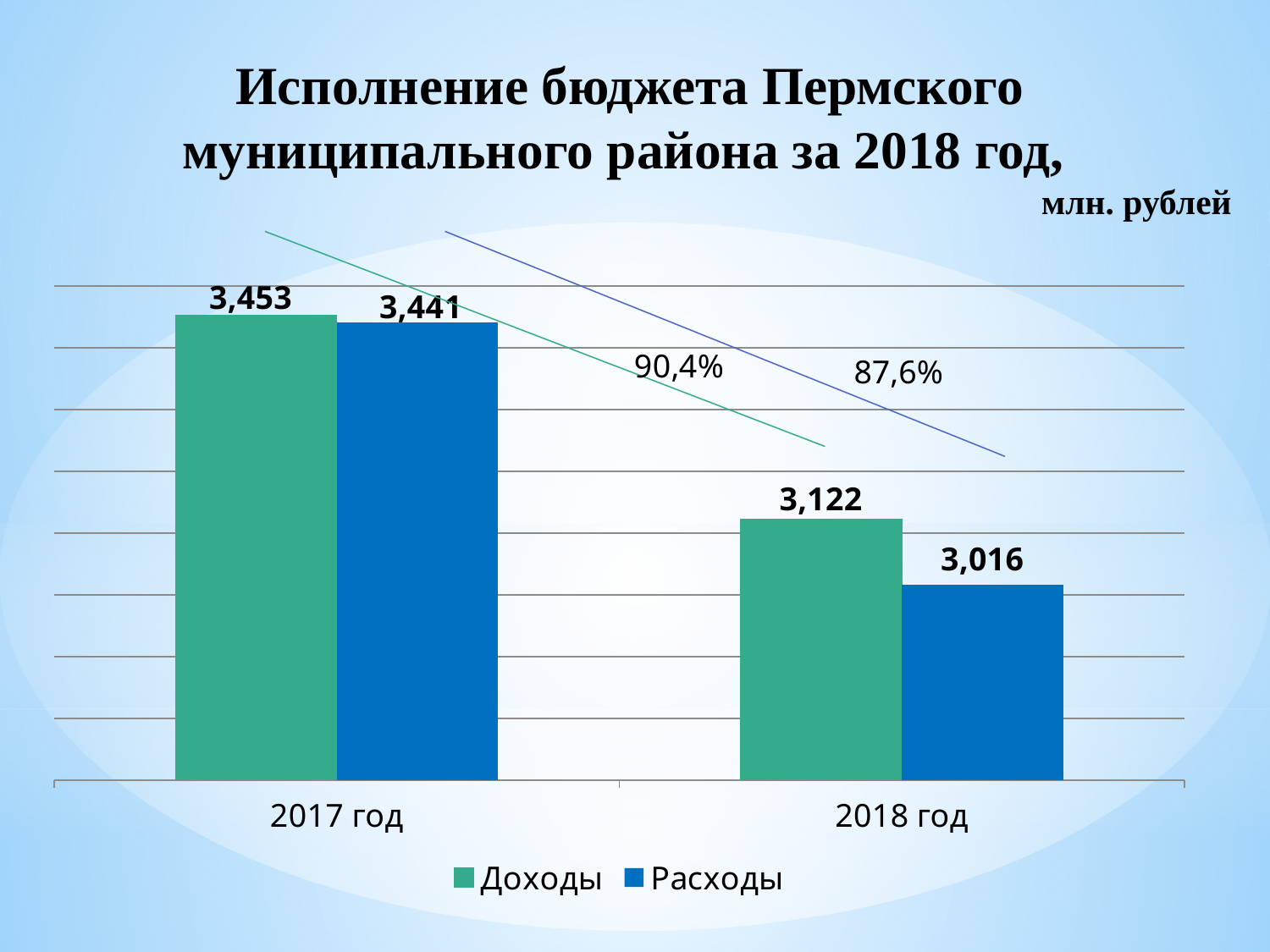
Which is larger for 2018 год, Доходы or Расходы? Доходы How many series does the legend list? 2 Which bar has the highest value on the chart? Доходы, 2017 год By how much did Доходы decrease from 2017 год to 2018 год? 331 What is the difference between Доходы and Расходы for 2018 год? 106 What is the value of Доходы for 2017 год? 3,453 What is the value of Расходы for 2018 год? 3,016 Which bar has the lowest value on the chart? Расходы, 2018 год What kind of chart is shown on the slide? Bar chart What is the value of Расходы for 2017 год? 3,441 Do the Расходы values rise or fall from 2017 год to 2018 год? Fall What is the value of Доходы for 2018 год? 3,122